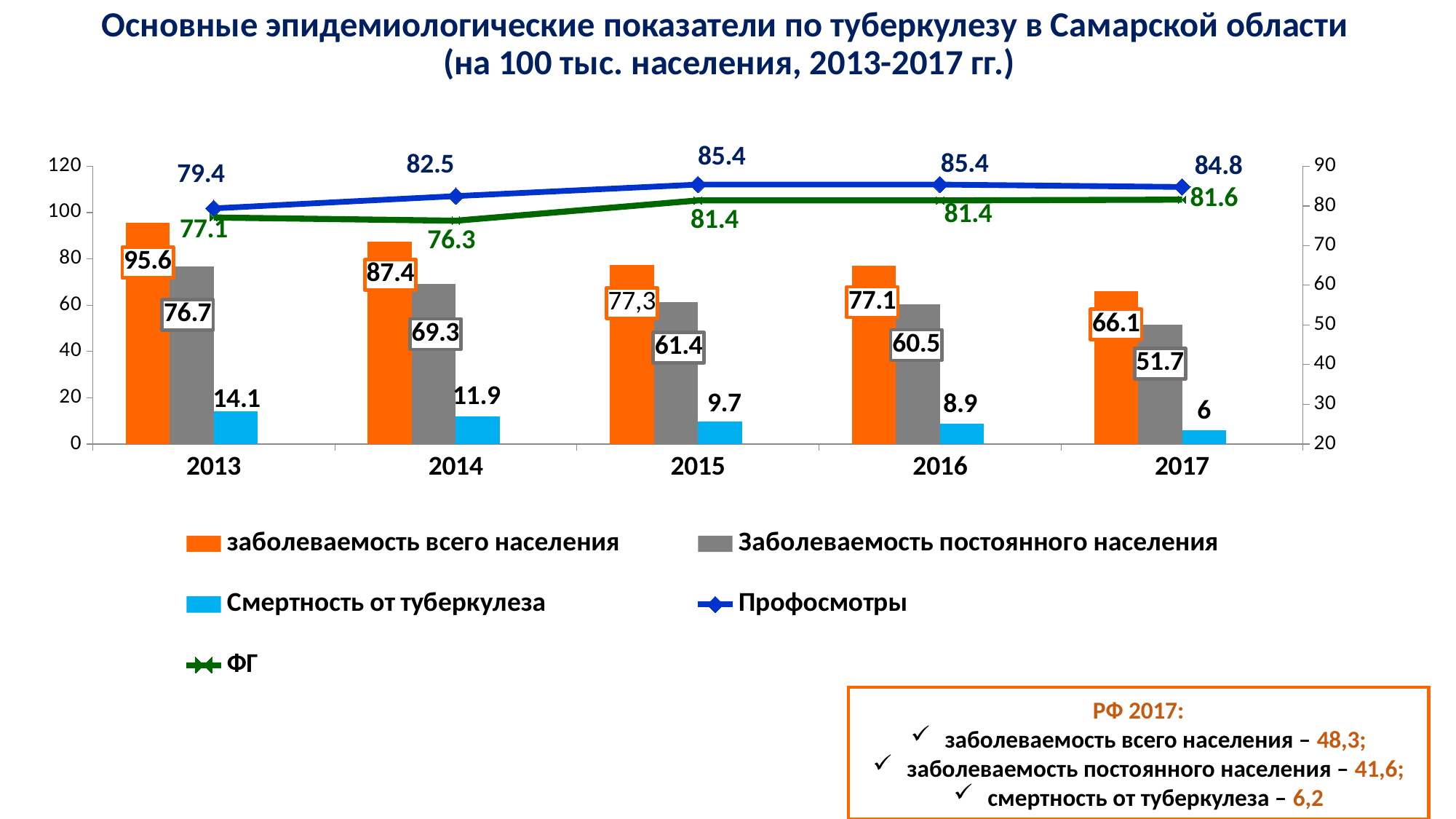
Which is larger: "Профосмотры" in 2013 or "ФГ" in 2013? Профосмотры in 2013 How many series does the legend list? 5 What is the value of "Профосмотры" for 2014? 82.5 In which year is "Смертность от туберкулеза" highest? 2013 Does "Смертность от туберкулеза" rise or fall from 2013 to 2017? fall What colour are the bars for "заболеваемость всего населения"? orange What is the value of "ФГ" for 2015? 81.4 In which year is "Заболеваемость постоянного населения" lowest? 2017 What is the value of "заболеваемость всего населения" for 2013? 95.6 How many years are shown on the x axis? 5 What is the value of "Смертность от туберкулеза" for 2017? 6 What is the difference between "заболеваемость всего населения" in 2013 and in 2017? 29.5